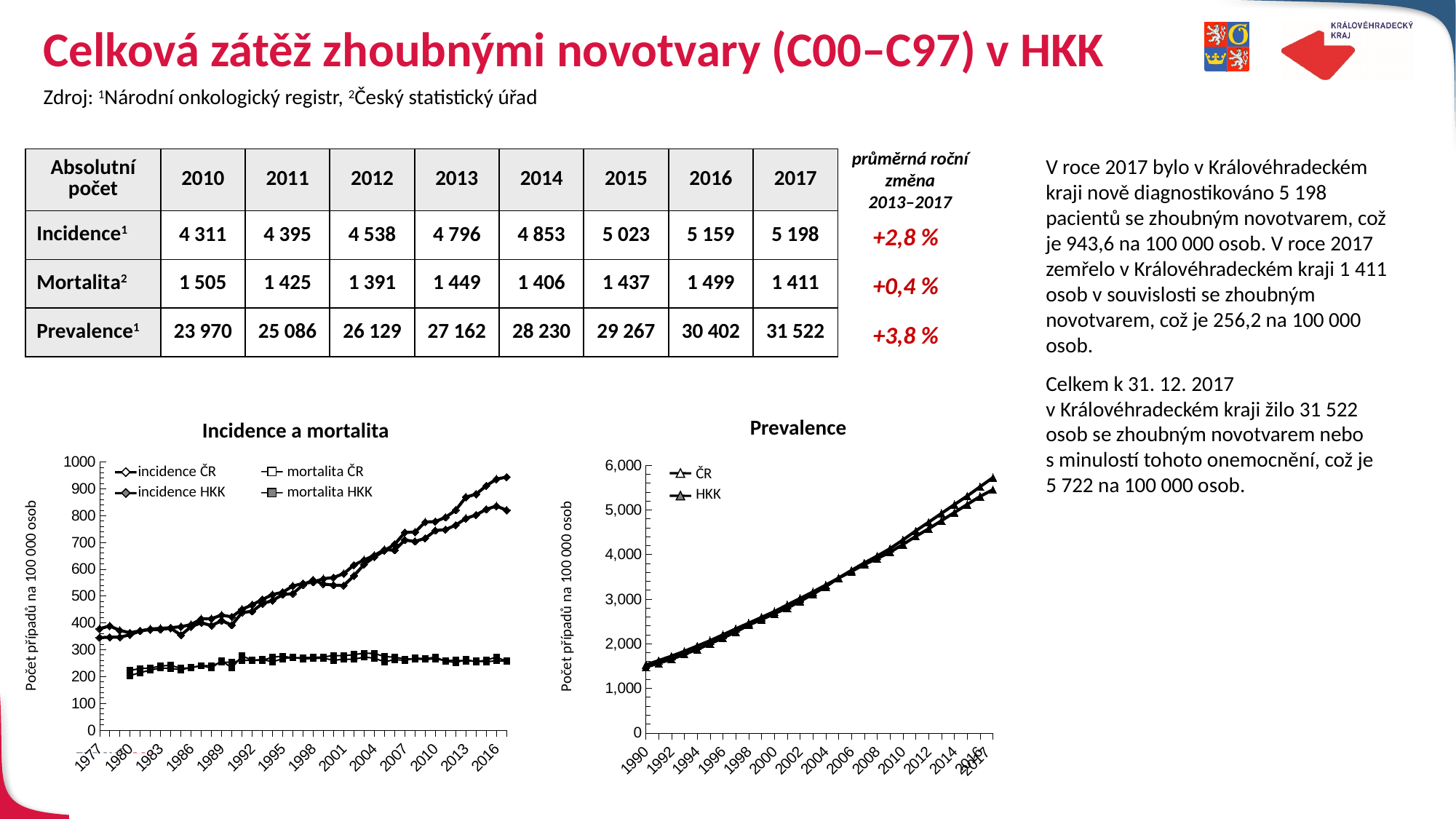
In the "Incidence a mortalita" chart, which series is higher in 2017: incidence HKK or incidence ČR? incidence HKK What kind of chart is the "Prevalence" chart? line chart What is the y-axis label of the "Prevalence" chart? Počet případů na 100 000 osob In the "Incidence a mortalita" chart, do the incidence values rise or fall from 1977 to 2017? rise In the "Prevalence" chart, is the value for HKK in 1990 greater or less than 2,000? less In the "Prevalence" chart, do the values rise or fall from 1990 to 2017? rise In the "Incidence a mortalita" chart, is the value for mortalita HKK in 2017 greater or less than 300? less How many series does the legend of the "Incidence a mortalita" chart list? 4 What kind of chart is the "Incidence a mortalita" chart? line chart In the "Incidence a mortalita" chart, is the value for incidence HKK in 2017 greater or less than 900? greater How many series does the legend of the "Prevalence" chart list? 2